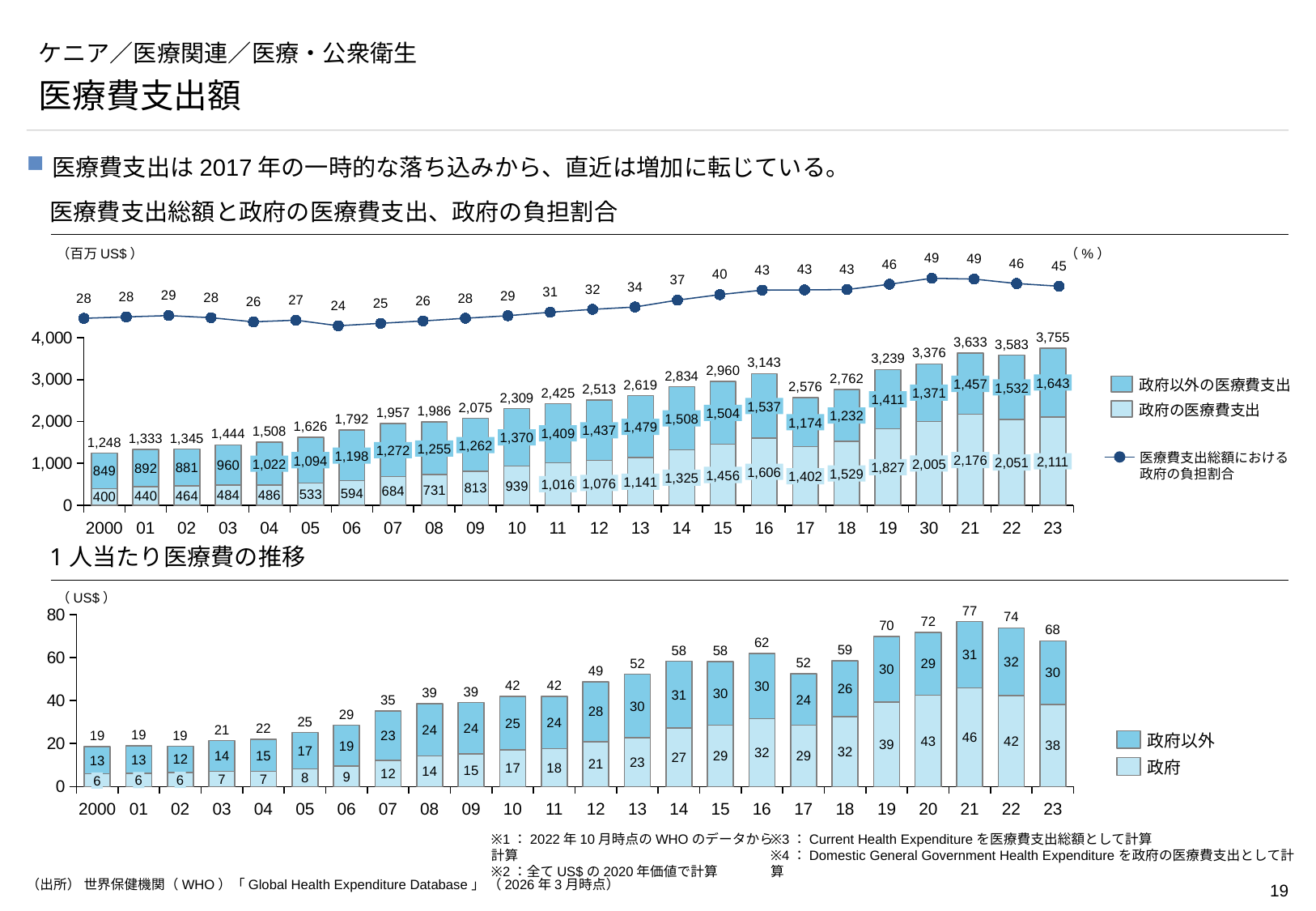
In the top chart, which is larger in 2019: 政府以外の医療費支出 or 政府の医療費支出? 政府の医療費支出 What type of chart is the bottom chart (1人当たり医療費の推移)? Stacked bar chart In the top chart, what is the government share (政府の負担割合) shown on the line for 2021? 49 In the bottom chart, what is the difference between the 政府以外 value and the 政府 value in 2012? 7 In the top chart, which year has the lowest government share on the line? 06 In the bottom chart, what is the 政府 value for 2023? 38 In the bottom chart, which year has the highest total per-capita health expenditure? 21 In the top chart, what is the government health expenditure (政府の医療費支出) for 2016? 1,606 In the top chart (医療費支出総額と政府の医療費支出、政府の負担割合), what is the total health expenditure for 2023? 3,755 In the bottom chart (1人当たり医療費の推移), what is the total per-capita health expenditure for 2021? 77 In the top chart, what is the difference between the total health expenditure in 2016 and in 2017? 567 In the top chart, how many series does the legend list? 3